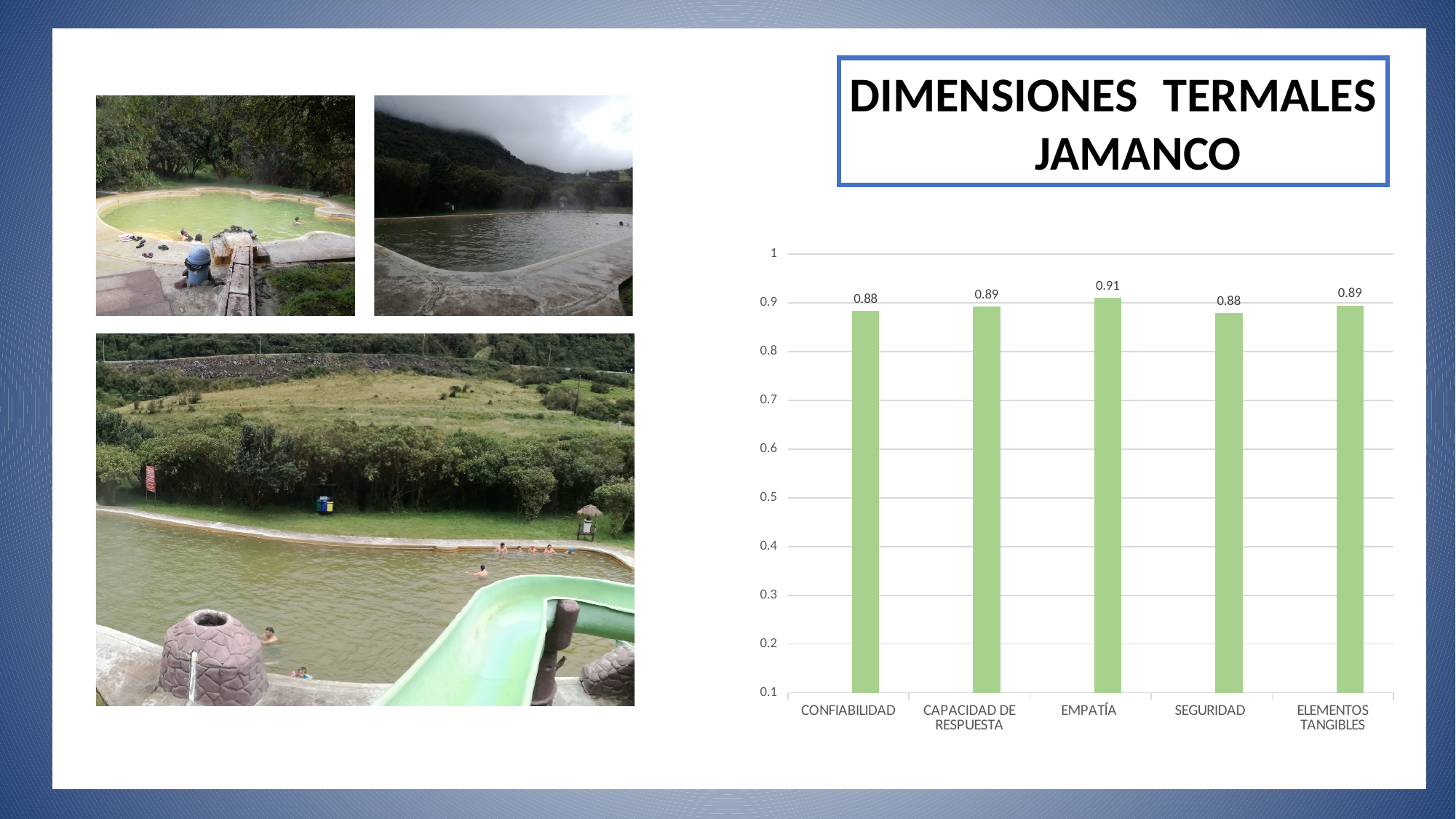
Which category has the highest value? EMPATÍA What is the value for ELEMENTOS TANGIBLES? 0.89 How many categories are shown on the x axis? 5 Is the value for SEGURIDAD greater or less than 0.8? greater What is the value for CONFIABILIDAD? 0.88 What is the value for EMPATÍA? 0.91 Which is larger, the value for EMPATÍA or the value for CONFIABILIDAD? EMPATÍA What kind of chart is shown on the slide? bar chart What is the value for SEGURIDAD? 0.88 What is the value for CAPACIDAD DE RESPUESTA? 0.89 What is the difference between the values for EMPATÍA and SEGURIDAD? 0.03 What is the title shown above the chart? DIMENSIONES TERMALES JAMANCO